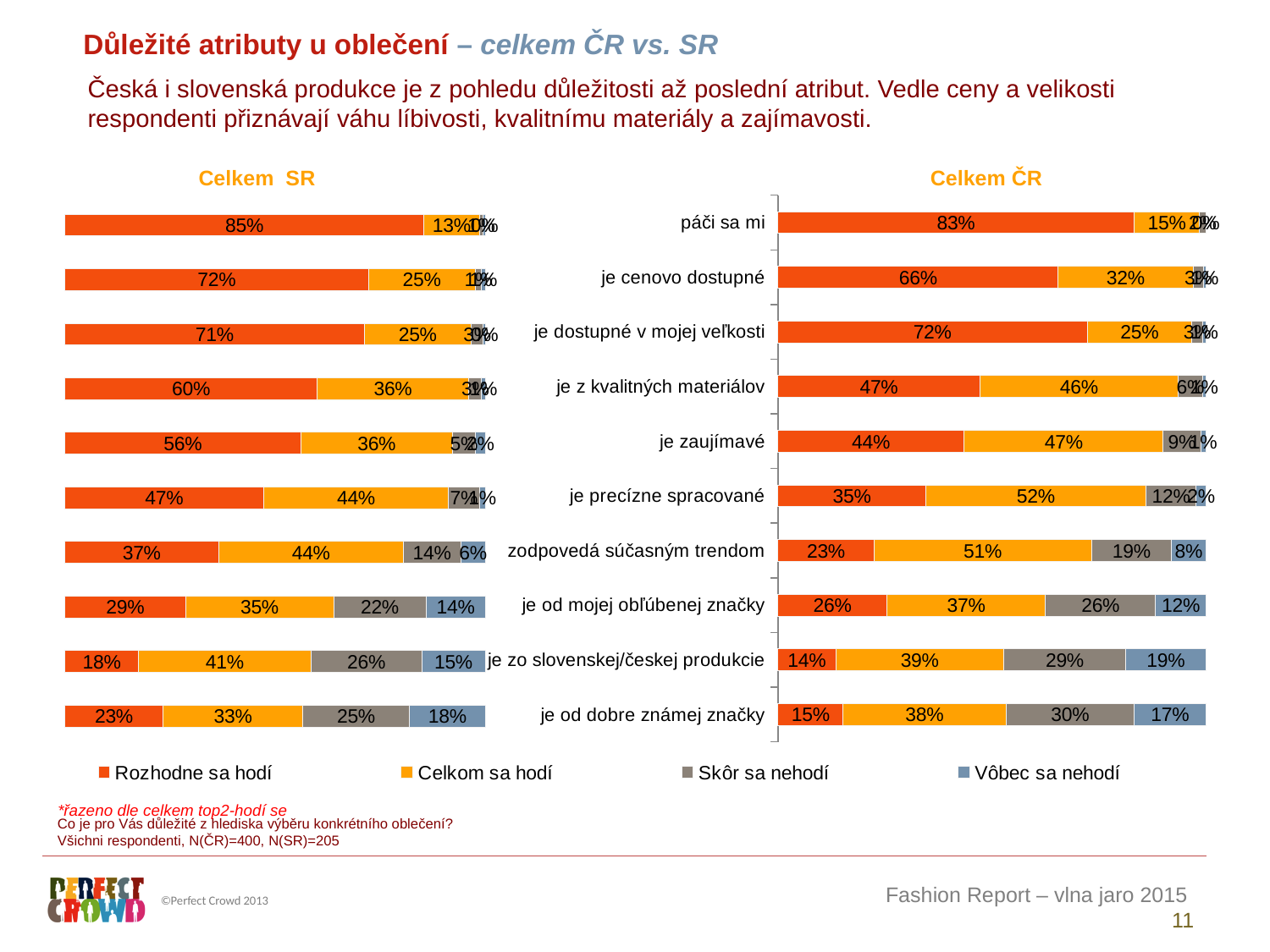
How many series does the legend list? 4 Which is larger: the 'Rozhodne sa hodí' value for 'je cenovo dostupné' in the Celkem SR chart or in the Celkem ČR chart? Celkem SR What type of chart is the Celkem SR chart? Stacked bar chart In the Celkem ČR chart, which attribute has the lowest 'Rozhodne sa hodí' value? je zo slovenskej/českej produkcie In the Celkem SR chart, what is the difference between the 'Rozhodne sa hodí' values for 'je cenovo dostupné' and 'je z kvalitných materiálov'? 12% In the Celkem ČR chart, what is the total of the 'Rozhodne sa hodí' and 'Celkom sa hodí' values for 'je od dobre známej značky'? 53% In the Celkem SR chart, which attribute has the highest 'Rozhodne sa hodí' value? páči sa mi In the Celkem ČR chart, what is the 'Celkom sa hodí' value for 'je precízne spracované'? 52% In the Celkem ČR chart, what is the 'Vôbec sa nehodí' value for 'je zo slovenskej/českej produkcie'? 19% In the Celkem SR chart, what is the 'Rozhodne sa hodí' value for 'páči sa mi'? 85% What colour represents the 'Skôr sa nehodí' series in the legend? Grey How many attributes (categories) are shown in the Celkem ČR chart? 10